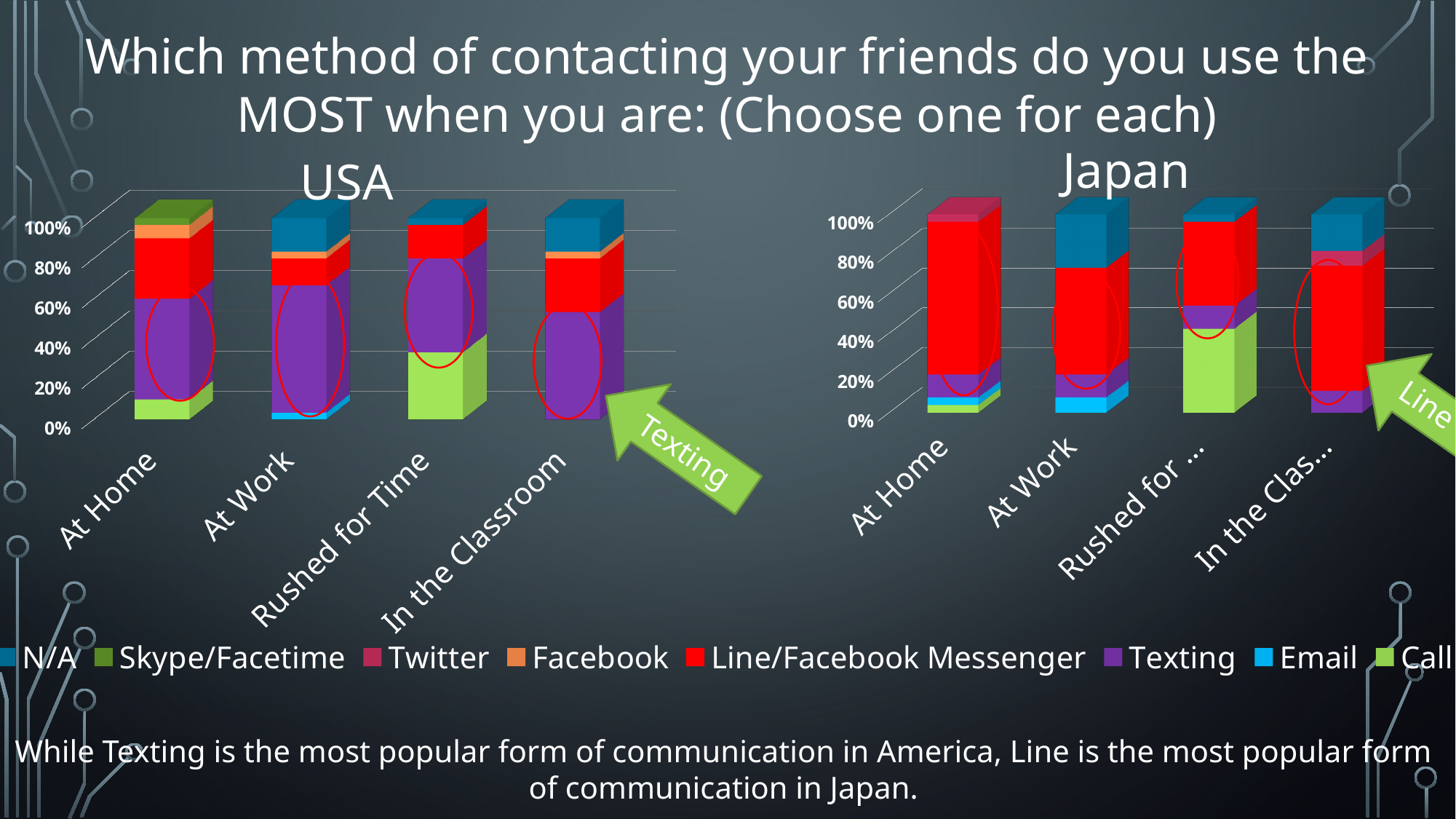
In the USA chart, is the Call share of the At Home bar greater or less than 20%? less How many series does the legend list? 8 Which series does the green arrow on the Japan chart point to? Line In the Japan chart, is the Call share of the Rushed for Time bar greater or less than 20%? greater In the USA chart, which series takes the largest share of the At Home bar? Texting In the USA chart, is the Call share of the Rushed for Time bar greater or less than 20%? greater What kind of chart is the USA chart? stacked bar chart In the USA chart, which series takes the largest share of the In the Classroom bar? Texting Which series does the green arrow on the USA chart point to? Texting How many categories are shown on the x axis of the USA chart? 4 In the Japan chart, which series takes the largest share of the At Home bar? Line/Facebook Messenger